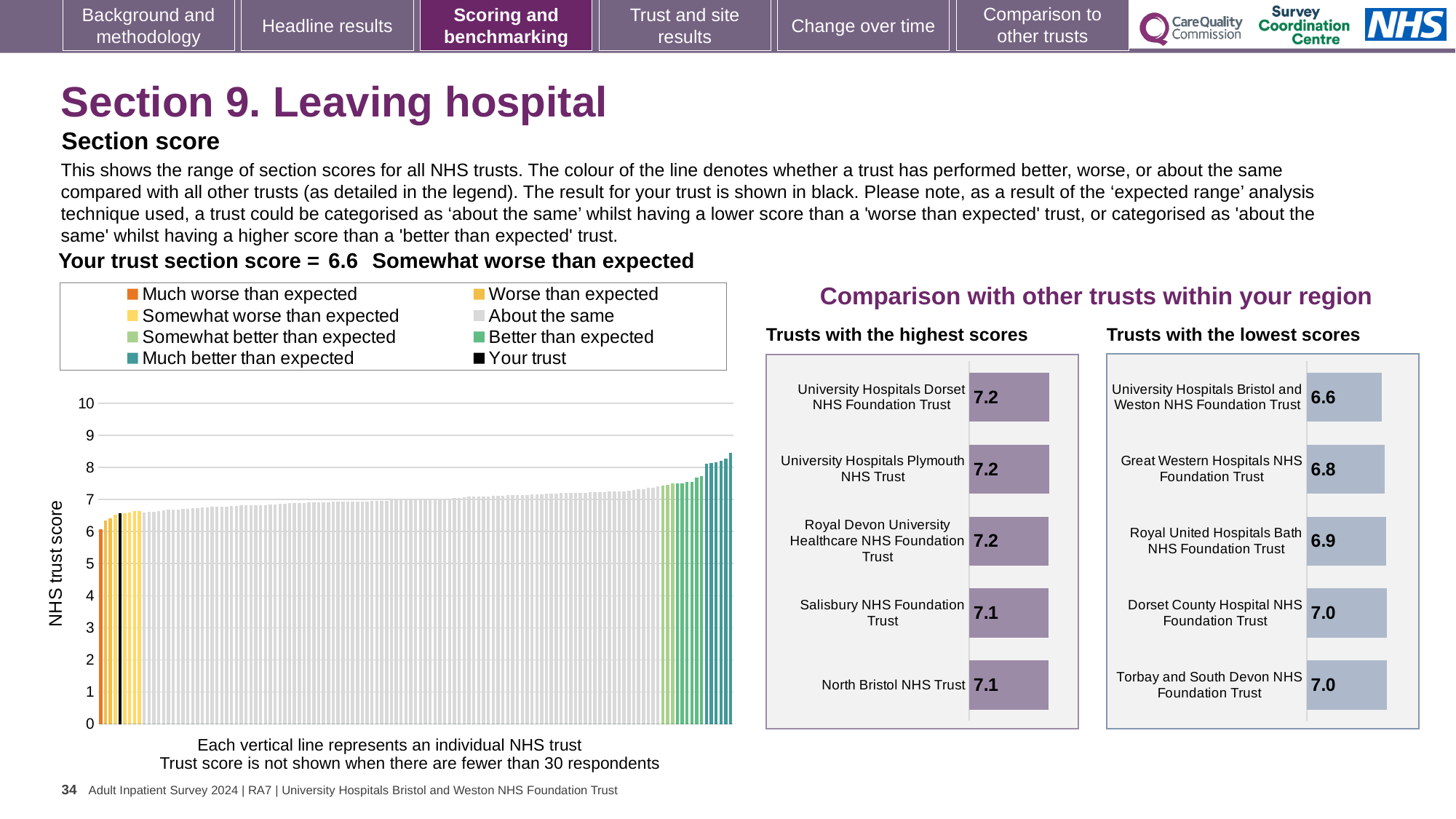
In the large chart of NHS trust scores on the left, do the values rise or fall from left to right? rise In the 'Trusts with the lowest scores' chart, what is the difference between the scores of Royal United Hospitals Bath NHS Foundation Trust and University Hospitals Bristol and Weston NHS Foundation Trust? 0.3 What kind of chart is the 'Trusts with the lowest scores' chart? bar chart In the 'Trusts with the lowest scores' chart, which has the higher score: Great Western Hospitals NHS Foundation Trust or Dorset County Hospital NHS Foundation Trust? Dorset County Hospital NHS Foundation Trust What is the trust section score stated on the slide for your trust? 6.6 In the 'Trusts with the highest scores' chart, what is the score for North Bristol NHS Trust? 7.1 In the 'Trusts with the highest scores' chart, what is the difference between the scores of University Hospitals Dorset NHS Foundation Trust and North Bristol NHS Trust? 0.1 In the 'Trusts with the lowest scores' chart, what is the score for Great Western Hospitals NHS Foundation Trust? 6.8 In the 'Trusts with the highest scores' chart, what is the score for Salisbury NHS Foundation Trust? 7.1 In the 'Trusts with the lowest scores' chart, which trust has the lowest score? University Hospitals Bristol and Weston NHS Foundation Trust How many trusts are shown in the 'Trusts with the highest scores' chart? 5 In the large chart of NHS trust scores on the left, what colour is used for the line representing your trust? black